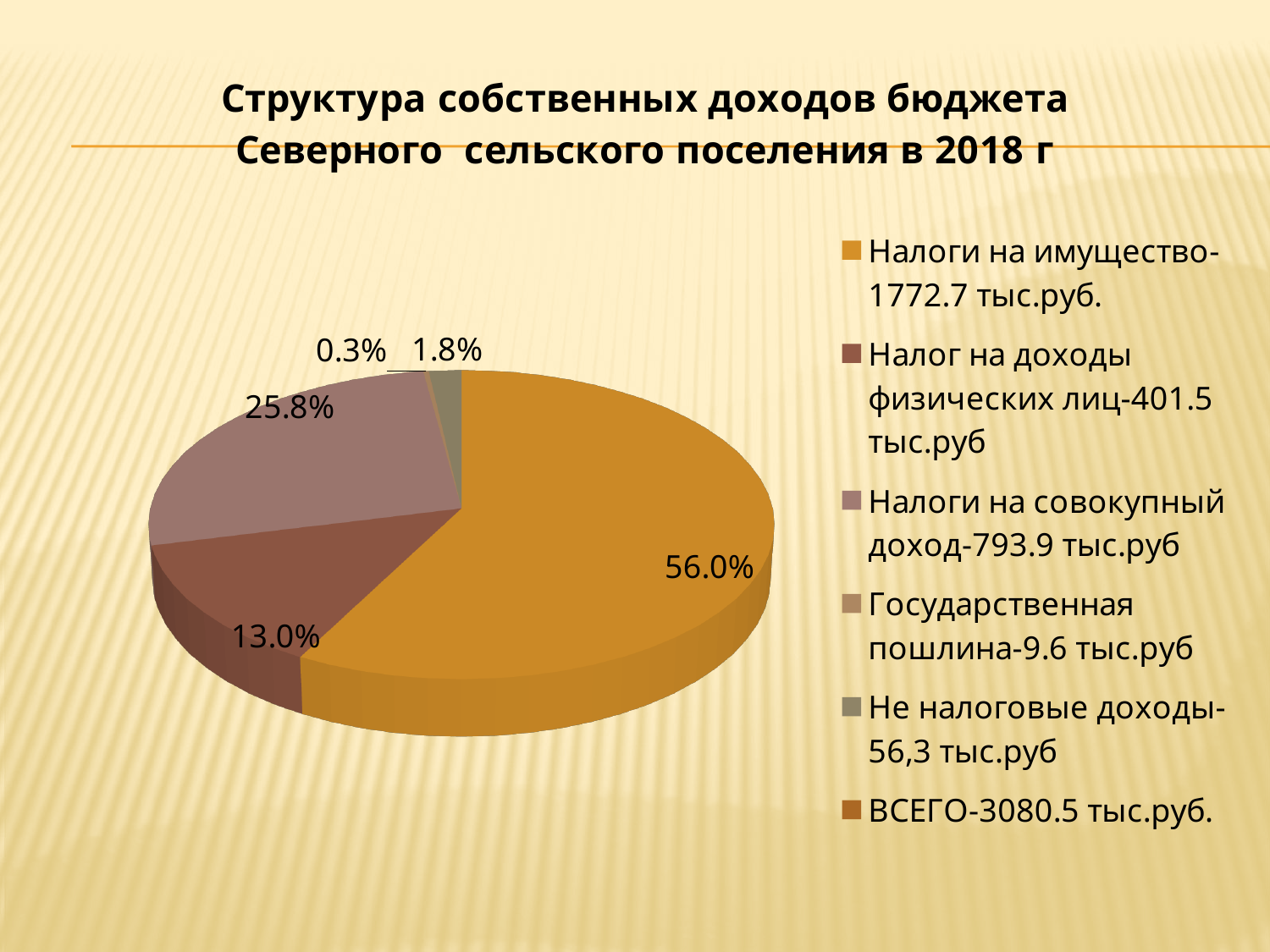
Which category has the largest slice of the pie? Налоги на имущество What total amount is given in the legend entry "ВСЕГО"? 3080.5 тыс.руб. What share of the pie does "Налог на доходы физических лиц" take? 13.0% What is the difference in percentage points between the "Налоги на имущество" slice and the "Налоги на совокупный доход" slice? 30.2 What kind of chart is shown on the slide? pie chart Which category has the smallest slice of the pie? Государственная пошлина What share of the pie does "Налоги на совокупный доход" take? 25.8% Which slice is larger: "Налог на доходы физических лиц" or "Налоги на совокупный доход"? Налоги на совокупный доход What share of the pie does "Налоги на имущество" take? 56.0% What share of the pie does "Государственная пошлина" take? 0.3% What share of the pie does "Не налоговые доходы" take? 1.8% How many entries does the legend list? 6